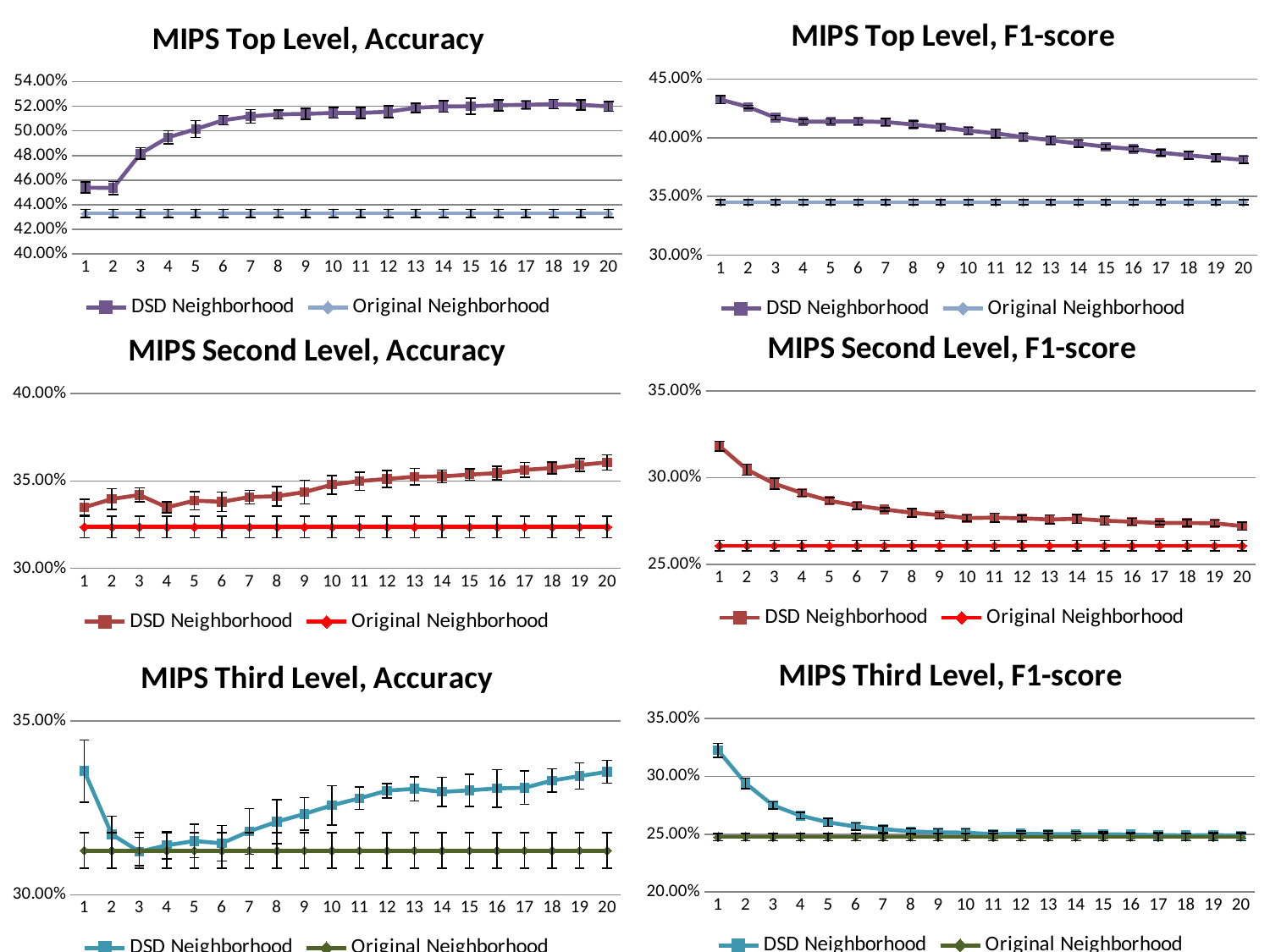
In "MIPS Second Level, Accuracy", what colour is the Original Neighborhood line? red In "MIPS Top Level, F1-score", does the DSD Neighborhood series rise or fall along the x axis? fall How many series does the legend of "MIPS Top Level, Accuracy" list? 2 In "MIPS Third Level, F1-score", does the DSD Neighborhood series rise or fall along the x axis? fall In "MIPS Second Level, Accuracy", which series has the larger value at 20, DSD Neighborhood or Original Neighborhood? DSD Neighborhood How many points are plotted along the x axis in "MIPS Top Level, F1-score"? 20 In "MIPS Top Level, Accuracy", is the DSD Neighborhood value at 20 greater or less than 50.00%? greater What kind of chart is "MIPS Top Level, Accuracy"? line chart In "MIPS Top Level, F1-score", is the DSD Neighborhood value at 1 greater or less than 40.00%? greater In "MIPS Top Level, Accuracy", does the DSD Neighborhood series rise or fall along the x axis? rise In "MIPS Second Level, F1-score", is the DSD Neighborhood value at 1 greater or less than 30.00%? greater